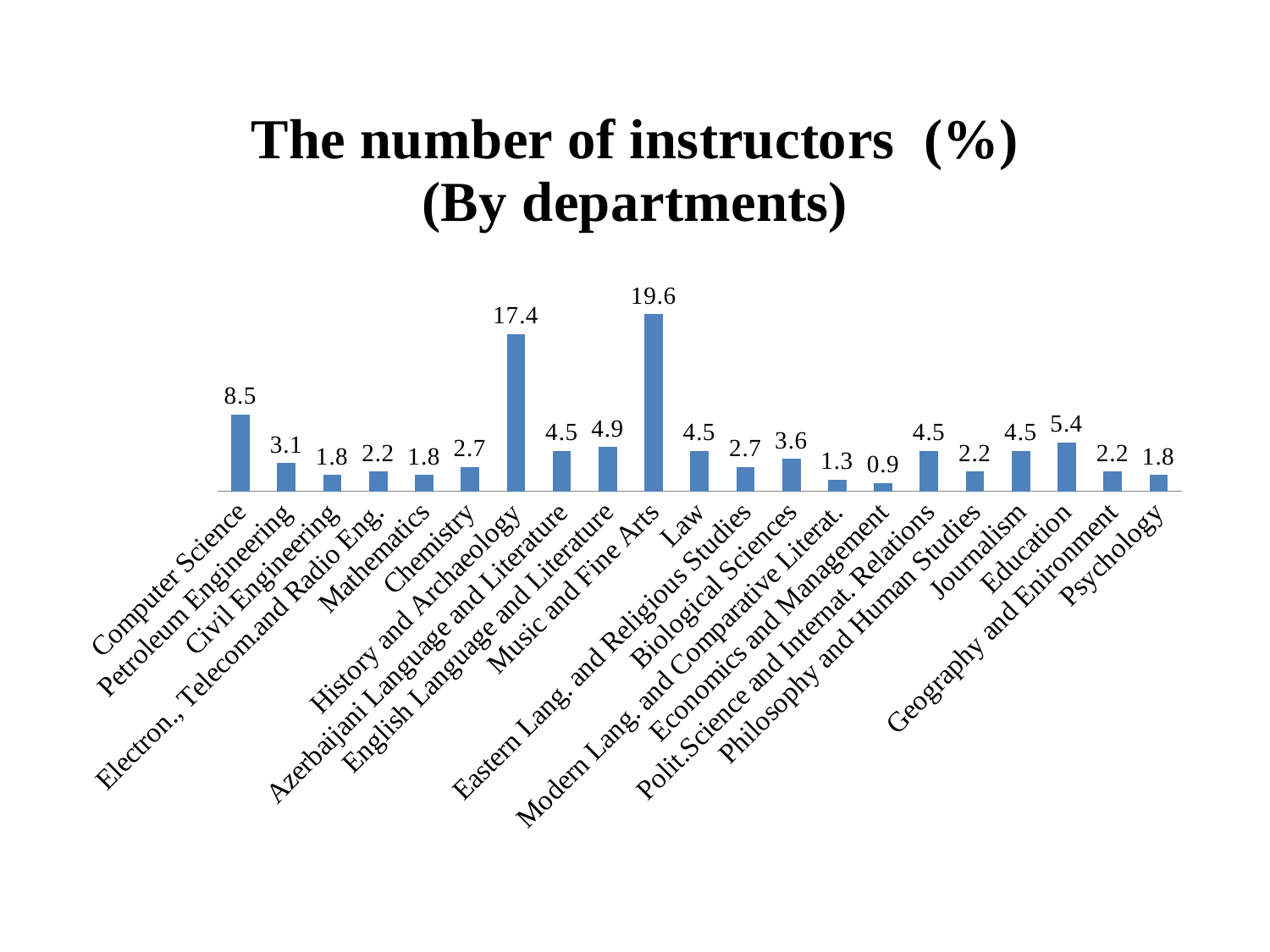
What kind of chart is shown on the slide? Bar chart Which department has the highest value? Music and Fine Arts Which department has the lowest value? Economics and Management What is the value for Education? 5.4 What is the value for History and Archaeology? 17.4 How many departments are shown in the chart? 21 What is the difference between the values for Computer Science and Education? 3.1 What is the difference between the values for Music and Fine Arts and History and Archaeology? 2.2 What is the value for Music and Fine Arts? 19.6 Which is larger, the value for English Language and Literature or the value for Biological Sciences? English Language and Literature What is the title of the chart? The number of instructors (%) (By departments) What is the value for Computer Science? 8.5